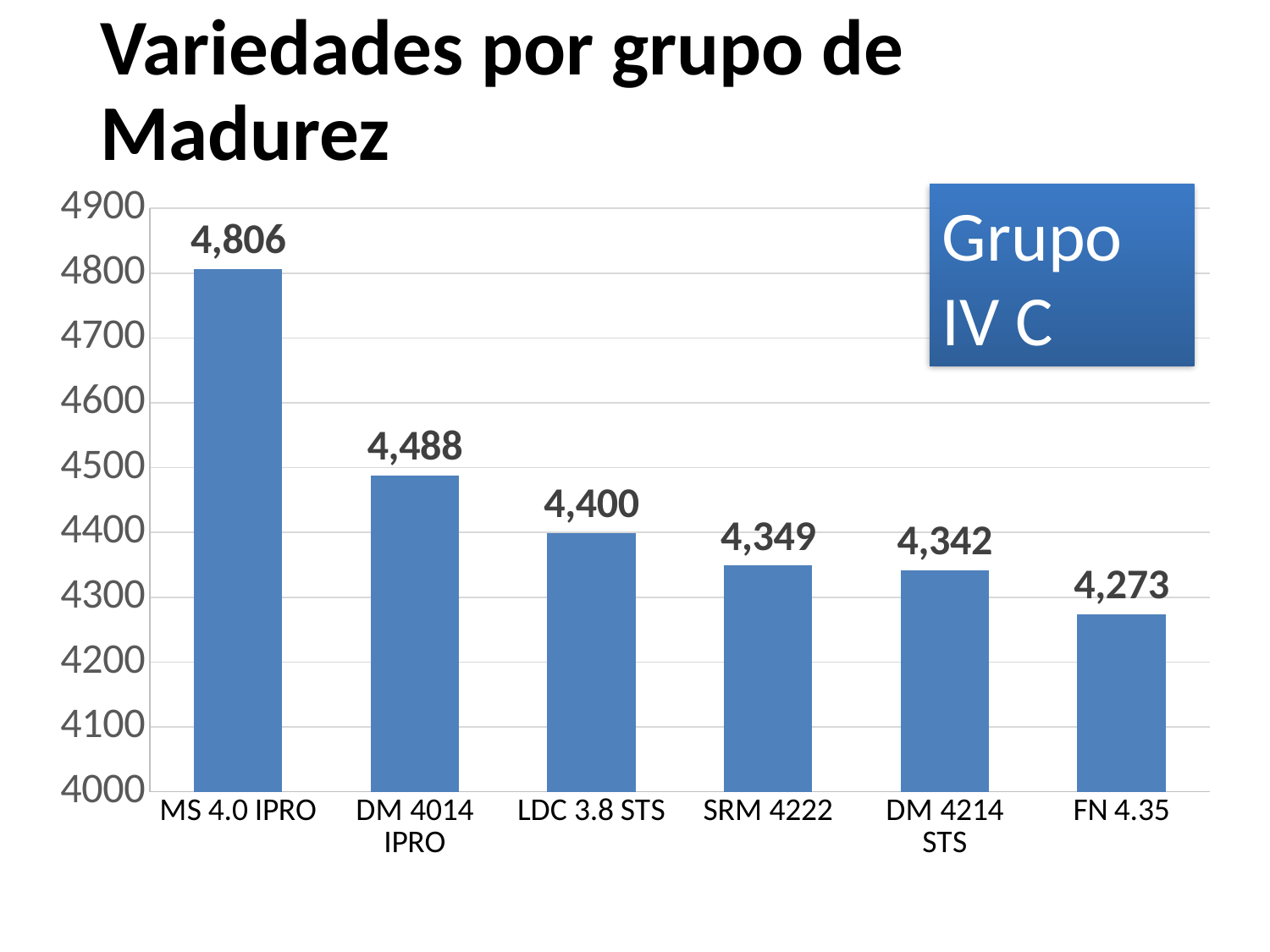
What kind of chart is shown on the slide? Bar chart How many varieties are shown in the chart? 6 Which variety has the highest value? MS 4.0 IPRO What is the value for DM 4014 IPRO? 4,488 What is the difference between the values for MS 4.0 IPRO and DM 4014 IPRO? 318 Which is larger, the value for LDC 3.8 STS or the value for FN 4.35? LDC 3.8 STS Which variety has the lowest value? FN 4.35 What is the difference between the values for SRM 4222 and DM 4214 STS? 7 Do the values rise or fall from left to right along the x axis? Fall What is the value for LDC 3.8 STS? 4,400 What is the value for FN 4.35? 4,273 What is the value for MS 4.0 IPRO? 4,806